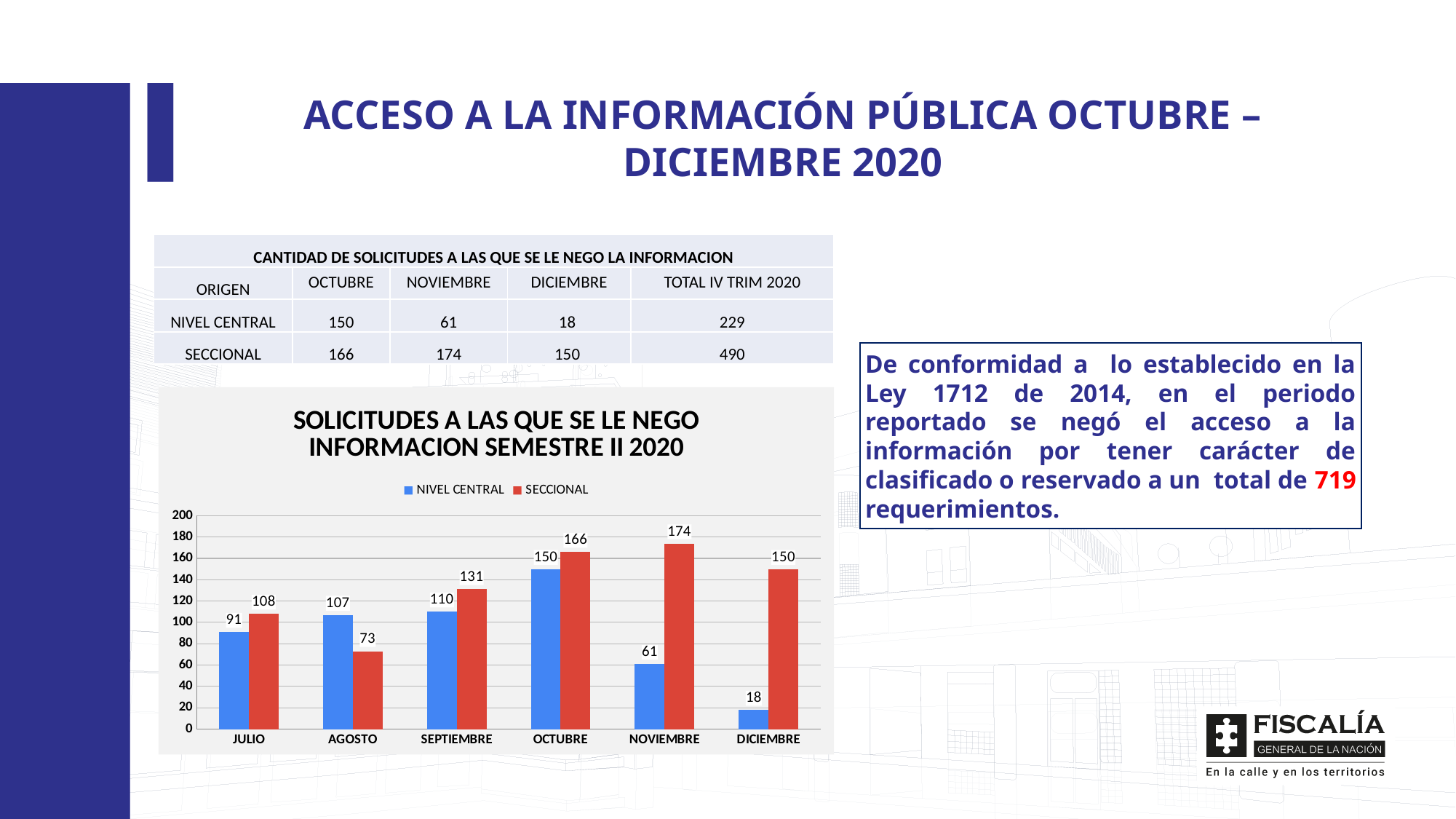
What is the title of the chart? SOLICITUDES A LAS QUE SE LE NEGO INFORMACION SEMESTRE II 2020 Is the value for SECCIONAL in SEPTIEMBRE greater or less than 120? greater Which month has the highest SECCIONAL value? NOVIEMBRE What kind of chart is shown on the slide? Bar chart Which month has the lowest NIVEL CENTRAL value? DICIEMBRE What is the value for NIVEL CENTRAL in JULIO? 91 What is the value for NIVEL CENTRAL in DICIEMBRE? 18 What is the difference between the SECCIONAL and NIVEL CENTRAL values in OCTUBRE? 16 In AGOSTO, which series has the larger value, NIVEL CENTRAL or SECCIONAL? NIVEL CENTRAL What is the value for SECCIONAL in NOVIEMBRE? 174 How many series does the chart legend list? 2 How many months are shown on the x axis of the chart? 6